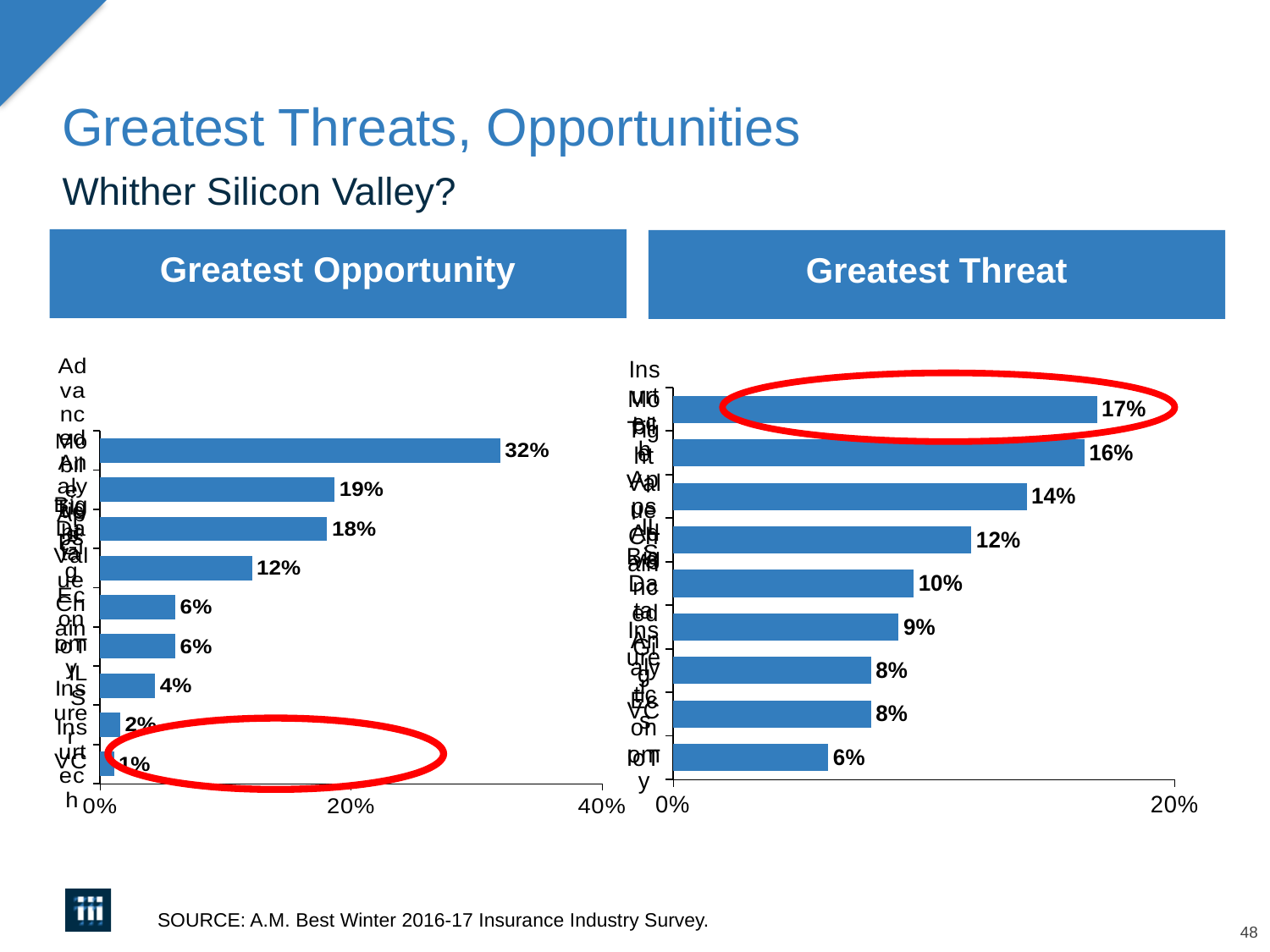
How many bars are plotted in the Greatest Threat chart? 9 In the Greatest Opportunity chart, what is the difference between the largest value and the second-largest value? 13% In the Greatest Opportunity chart, what is the value of the longest bar? 32% In the Greatest Opportunity chart, what is the value of the shortest bar? 1% In the Greatest Threat chart, what is the difference between the largest value and the smallest value? 11% In the Greatest Threat chart, what is the value of the longest bar? 17% What kind of chart is the Greatest Threat chart? Bar chart Which chart has the larger top value, Greatest Opportunity or Greatest Threat? Greatest Opportunity What is the maximum value shown on the x axis of the Greatest Opportunity chart? 40% What is the value of the bar circled in red in the Greatest Threat chart? 17% How many bars are plotted in the Greatest Opportunity chart? 9 In the Greatest Threat chart, what is the value of the shortest bar? 6%